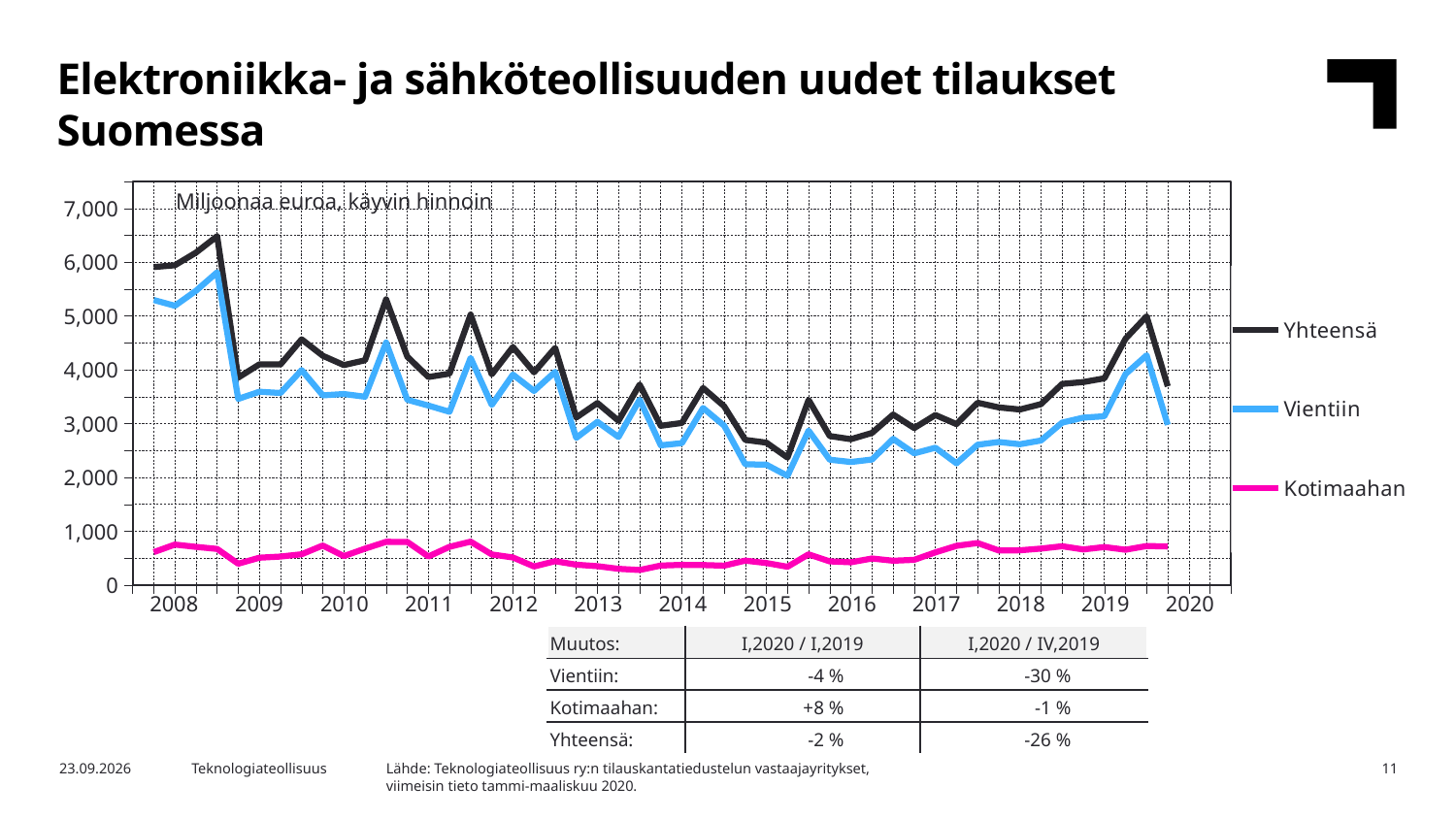
Is the value for Vientiin at the start of 2008 greater or less than 5,000? greater Is the value for Yhteensä at the end of 2016 greater or less than 4,000? less Which series is plotted with the highest values throughout the chart? Yhteensä How many year labels are shown on the x axis? 13 Which series is plotted with the lowest values throughout the chart? Kotimaahan How many series does the legend list? 3 Which is larger in 2019, Vientiin or Kotimaahan? Vientiin Is the value for Kotimaahan in 2018 greater or less than 1,000? less What unit is stated in the label at the top of the chart? Miljoonaa euroa, käyvin hinnoin Does the Yhteensä line generally rise or fall from 2008 to 2016? fall What kind of chart is shown on the slide? line chart